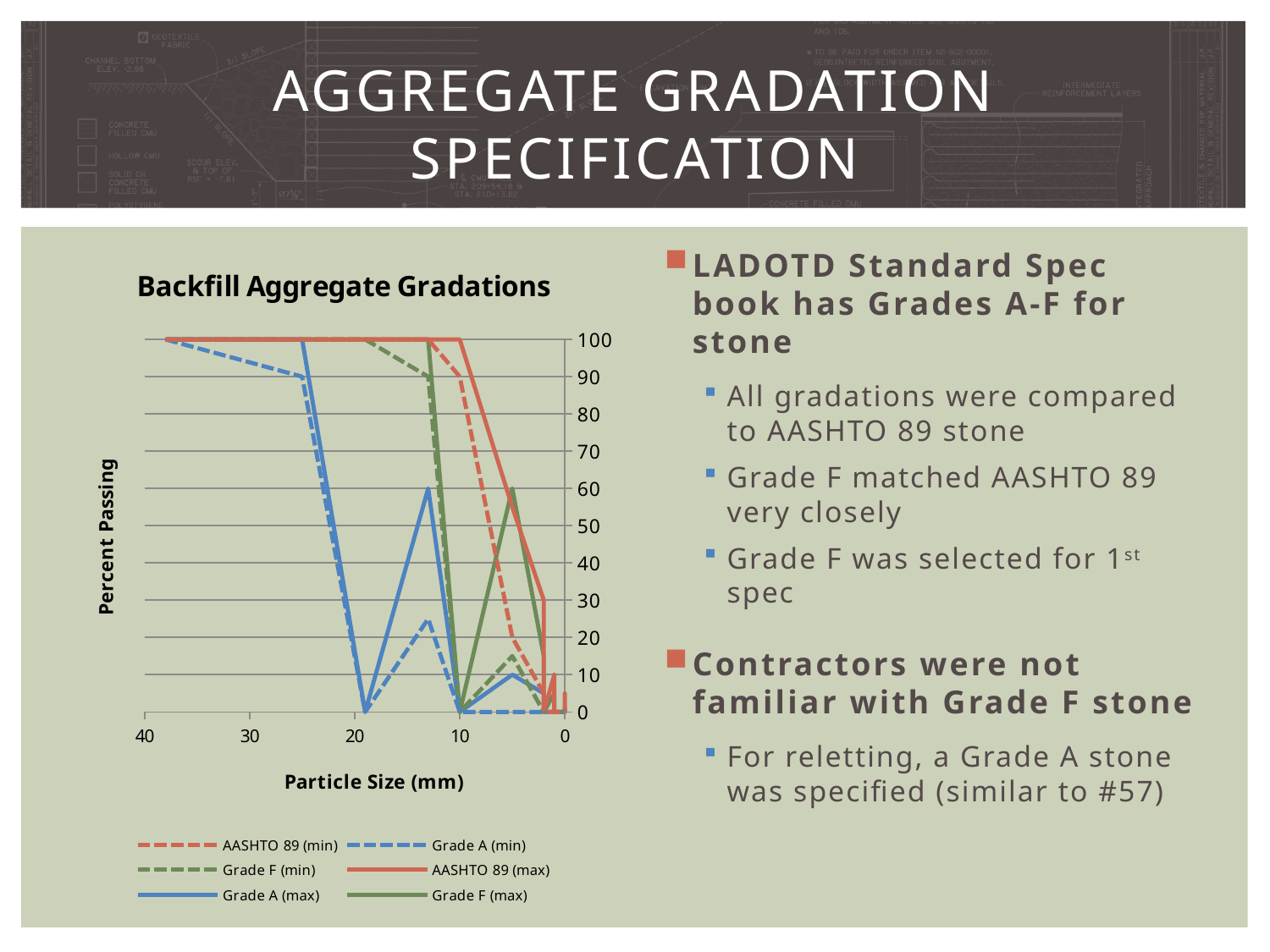
What kind of chart is "Backfill Aggregate Gradations"? Line chart In the "Backfill Aggregate Gradations" chart, is the value for Grade F (max) at a particle size of 5 mm greater or less than 50? greater How many series does the legend of the "Backfill Aggregate Gradations" chart list? 6 What is the label of the vertical axis of the "Backfill Aggregate Gradations" chart? Percent Passing In the "Backfill Aggregate Gradations" chart, is the value for Grade F (min) at a particle size of 5 mm greater or less than 30? less In the "Backfill Aggregate Gradations" chart, is the value for Grade A (min) at a particle size of 30 mm greater or less than 80? greater In the "Backfill Aggregate Gradations" chart, which series is larger at a particle size of 20 mm: AASHTO 89 (max) or Grade A (max)? AASHTO 89 (max) What is the title of the chart on the slide? Backfill Aggregate Gradations In the "Backfill Aggregate Gradations" chart, moving along the x axis from 40 mm toward 0 mm, do the Grade A (max) values generally rise or fall? fall